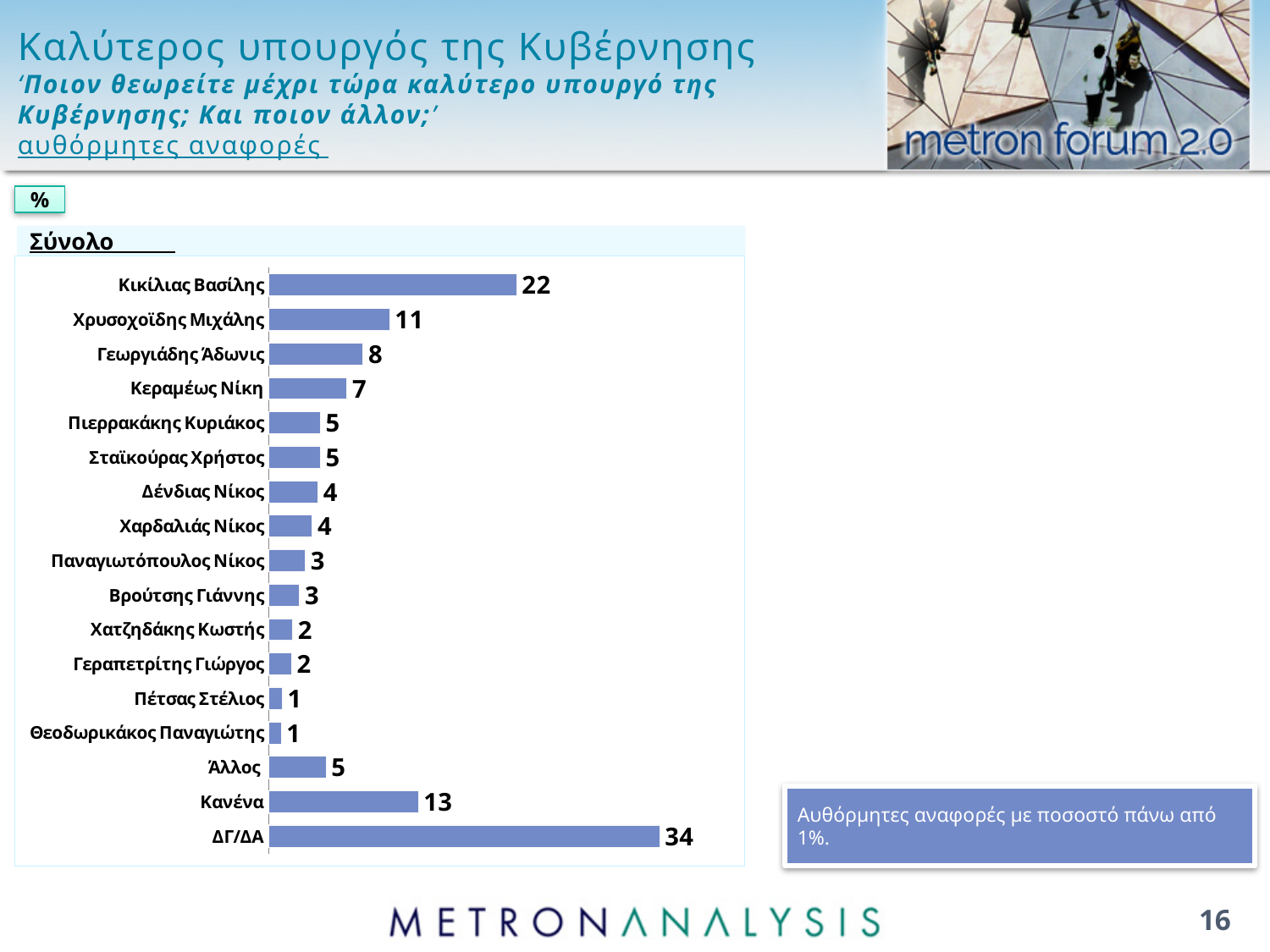
How many categories are shown in the chart? 17 What is the difference between the values for ΔΓ/ΔΑ and Κανένα? 21 What is the difference between the values for Κικίλιας Βασίλης and Χρυσοχοΐδης Μιχάλης? 11 What value is shown for Κεραμέως Νίκη? 7 What value is shown for Χρυσοχοΐδης Μιχάλης? 11 What value is shown for Κικίλιας Βασίλης? 22 What kind of chart is shown on the slide? Bar chart Which category has the highest value in the chart? ΔΓ/ΔΑ Which is larger, the value for Γεωργιάδης Άδωνις or the value for Κεραμέως Νίκη? Γεωργιάδης Άδωνις What value is shown for ΔΓ/ΔΑ? 34 What value is shown for Κανένα? 13 Which named minister has the highest value in the chart? Κικίλιας Βασίλης